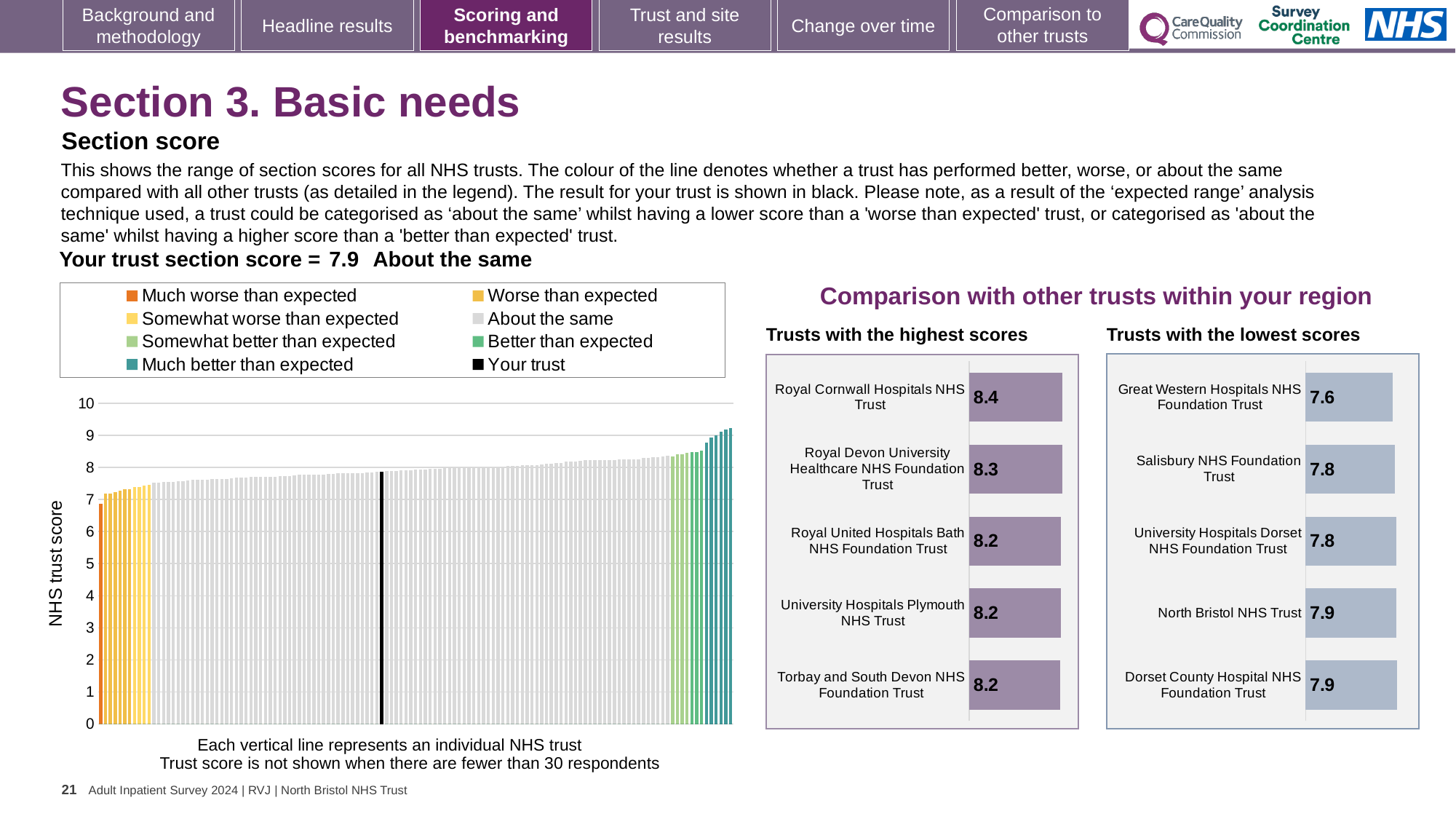
In the large chart on the left, do the NHS trust scores rise or fall from left to right? Rise In the 'Trusts with the highest scores' chart, what is the difference between the scores of Royal Cornwall Hospitals NHS Trust and Torbay and South Devon NHS Foundation Trust? 0.2 In the 'Trusts with the lowest scores' chart, which trust has the lowest score? Great Western Hospitals NHS Foundation Trust How many entries does the legend of the large chart on the left list? 8 In the large chart on the left, what colour is the bar representing your trust? Black In the 'Trusts with the lowest scores' chart, what is the score for Great Western Hospitals NHS Foundation Trust? 7.6 In the 'Trusts with the lowest scores' chart, how much higher is North Bristol NHS Trust's score than Great Western Hospitals NHS Foundation Trust's score? 0.3 In the 'Trusts with the highest scores' chart, which trust has the highest score? Royal Cornwall Hospitals NHS Trust How many trusts are shown in the 'Trusts with the highest scores' chart? 5 In the 'Trusts with the highest scores' chart, what is the score for Royal Cornwall Hospitals NHS Trust? 8.4 In the 'Trusts with the highest scores' chart, which has the larger score: Royal Devon University Healthcare NHS Foundation Trust or Royal United Hospitals Bath NHS Foundation Trust? Royal Devon University Healthcare NHS Foundation Trust What kind of chart is the large chart on the left showing NHS trust scores? Bar chart